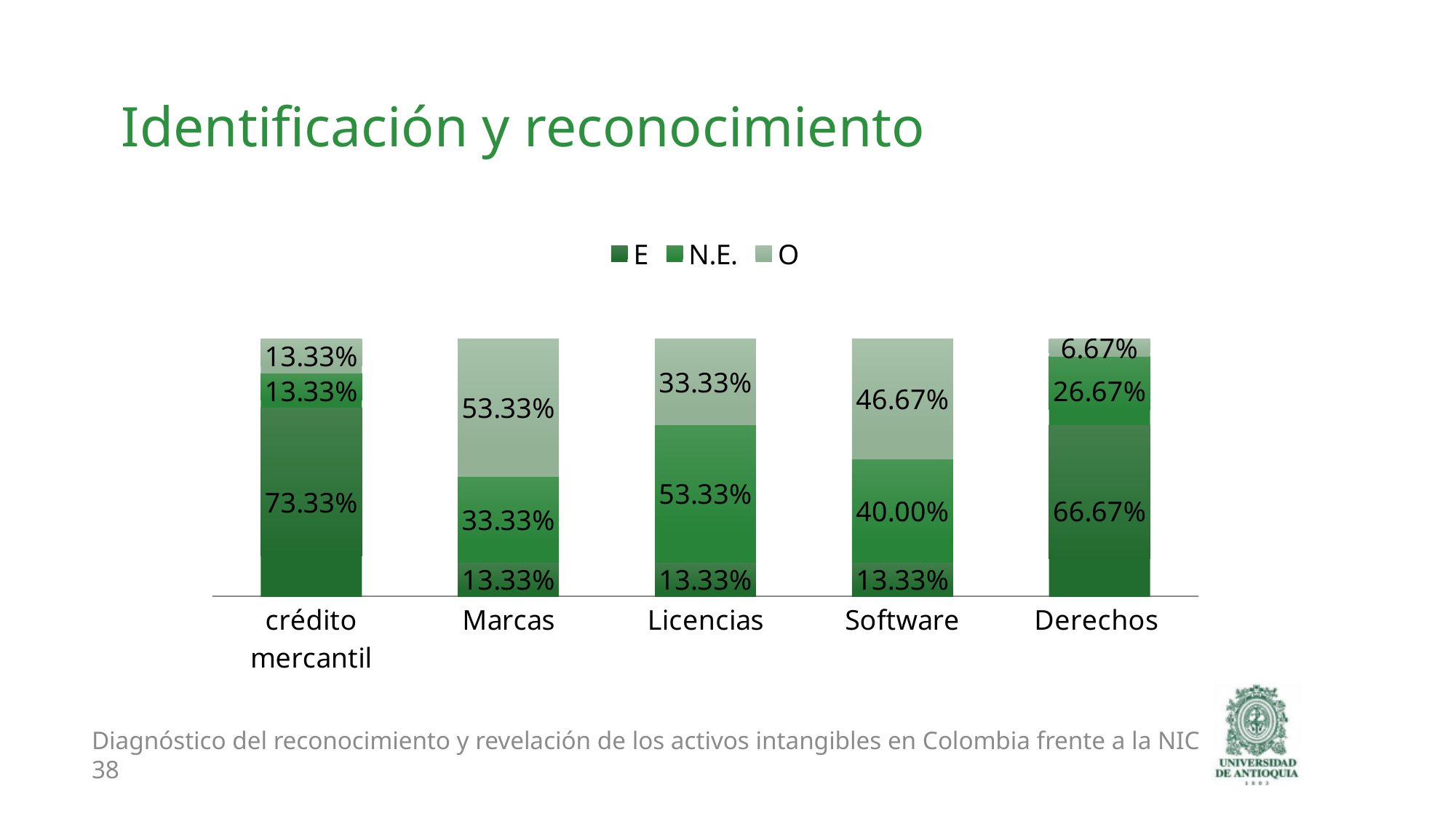
What is the value of the N.E. series for Software? 40.00% What is the difference between the N.E. values for Licencias and Marcas? 20.00% How many series does the legend list? 3 What are the names of the series in the legend? E, N.E., O What is the value of the O series for Derechos? 6.67% What is the value of the E series for crédito mercantil? 73.33% Which category has the highest value for the E series? crédito mercantil How many categories are shown on the x axis? 5 Which is larger: the O value for Software or the O value for Licencias? Software What is the value of the O series for Marcas? 53.33% Which category has the lowest value for the O series? Derechos What type of chart is shown on the slide? Stacked bar chart